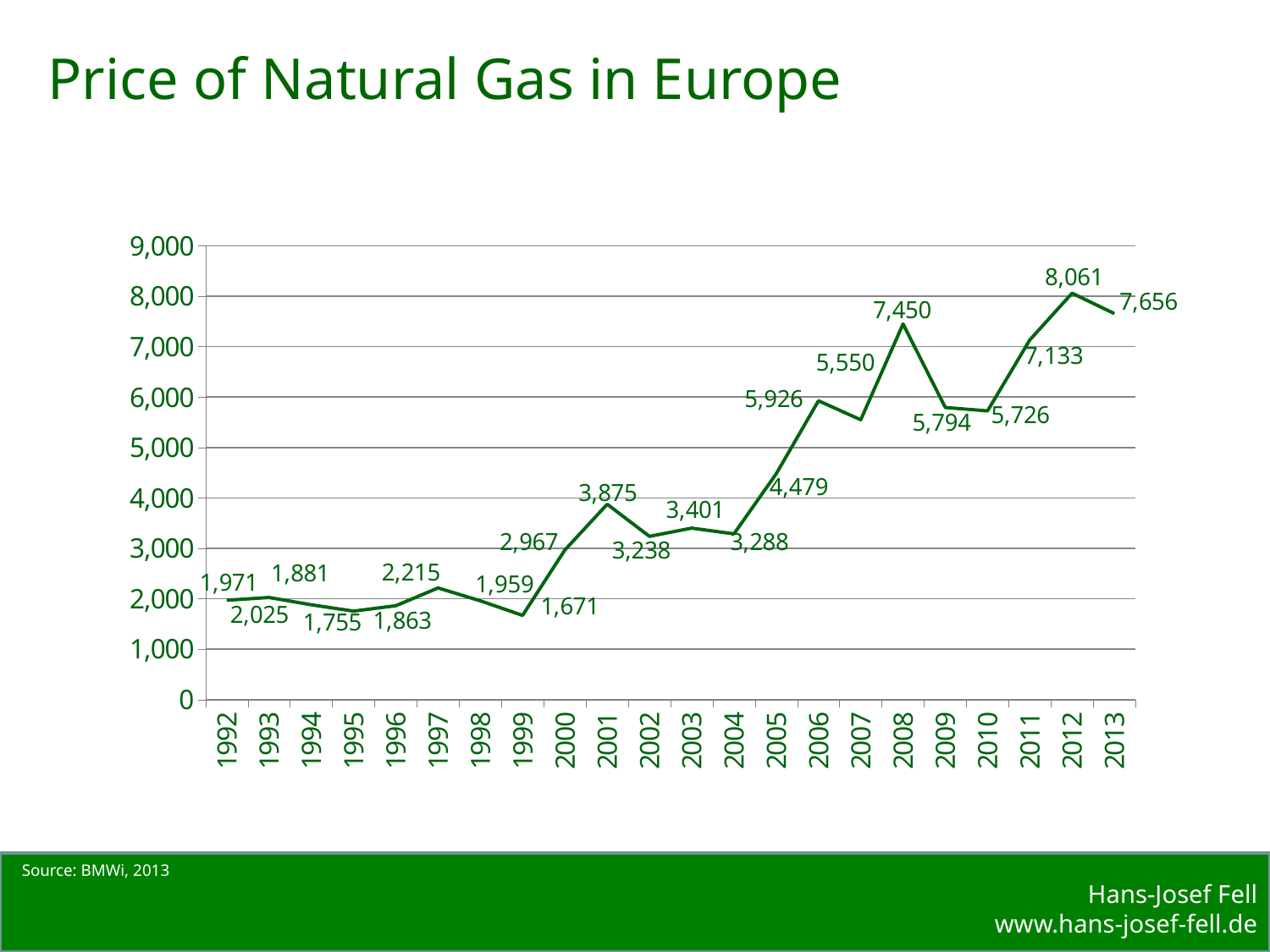
Is the value for 2011 greater or less than 7,000? greater How much higher is the 2008 value than the 2009 value? 1,656 What value is shown for 1999? 1,671 What is the difference between the values for 2012 and 2013? 405 Overall, does the price of natural gas rise or fall from 1992 to 2013? Rise Which year has the highest price of natural gas? 2012 What is the value plotted for 2005? 4,479 Which year has a higher value, 2006 or 2007? 2006 Which year has the lowest price of natural gas? 1999 What kind of chart is shown on the slide? Line chart What is the price of natural gas in Europe in 2008? 7,450 How many years are plotted on the chart? 22